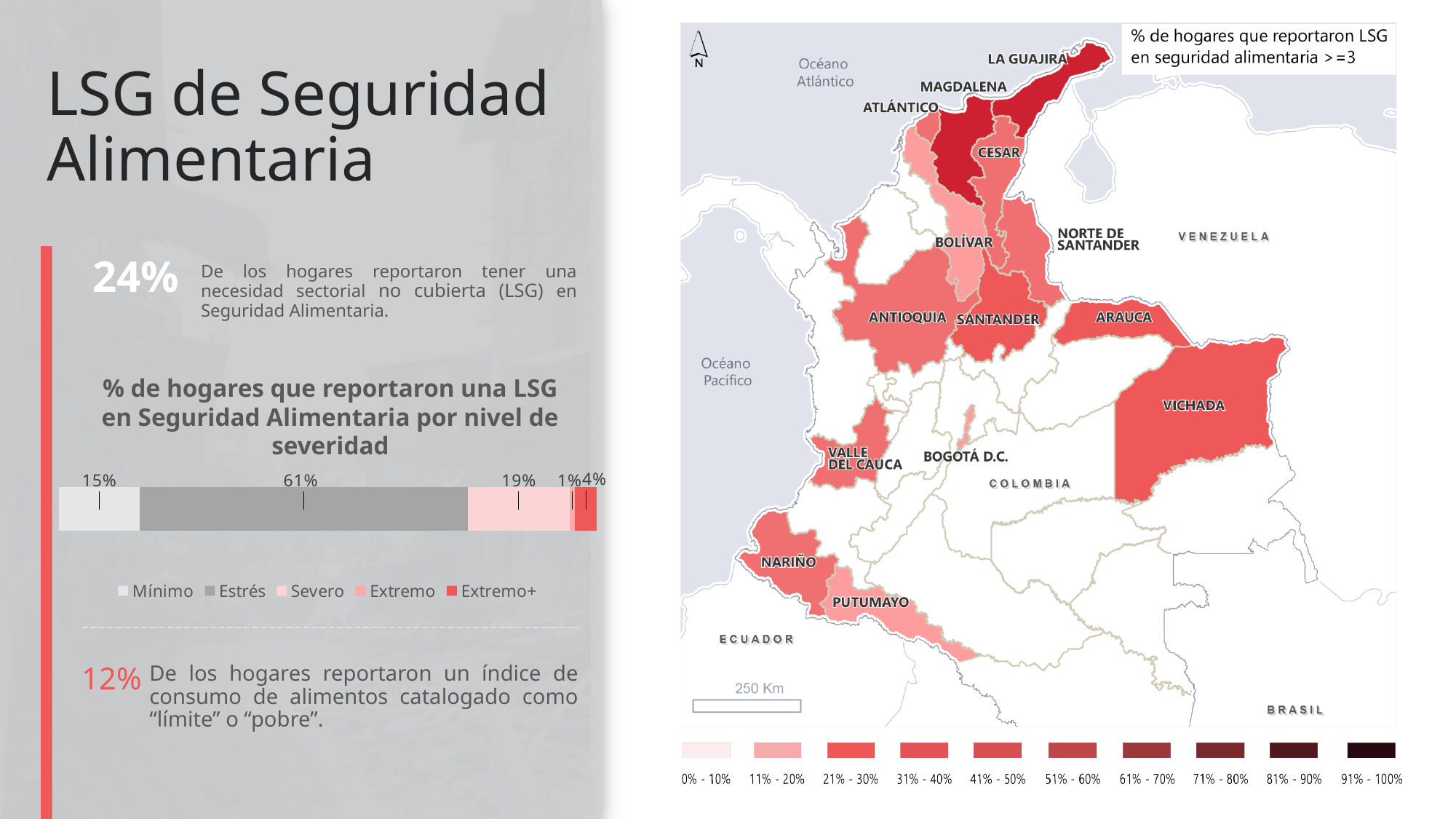
In the chart '% de hogares que reportaron una LSG en Seguridad Alimentaria por nivel de severidad', what is the value for Mínimo? 15% In the chart '% de hogares que reportaron una LSG en Seguridad Alimentaria por nivel de severidad', which is larger, Mínimo or Severo? Severo In the chart '% de hogares que reportaron una LSG en Seguridad Alimentaria por nivel de severidad', what is the value for Estrés? 61% In the chart '% de hogares que reportaron una LSG en Seguridad Alimentaria por nivel de severidad', what is the value for Severo? 19% In the chart '% de hogares que reportaron una LSG en Seguridad Alimentaria por nivel de severidad', what is the difference between the values for Estrés and Severo? 42% In the chart '% de hogares que reportaron una LSG en Seguridad Alimentaria por nivel de severidad', what is the total of the stacked bar? 100% In the chart '% de hogares que reportaron una LSG en Seguridad Alimentaria por nivel de severidad', which severity level has the lowest value? Extremo What kind of chart is '% de hogares que reportaron una LSG en Seguridad Alimentaria por nivel de severidad'? Stacked bar chart In the chart '% de hogares que reportaron una LSG en Seguridad Alimentaria por nivel de severidad', which legend entry is shown in the darkest red colour? Extremo+ In the chart '% de hogares que reportaron una LSG en Seguridad Alimentaria por nivel de severidad', which severity level has the highest value? Estrés In the chart '% de hogares que reportaron una LSG en Seguridad Alimentaria por nivel de severidad', what is the value for Extremo+? 4% How many series does the legend of the chart '% de hogares que reportaron una LSG en Seguridad Alimentaria por nivel de severidad' list? 5